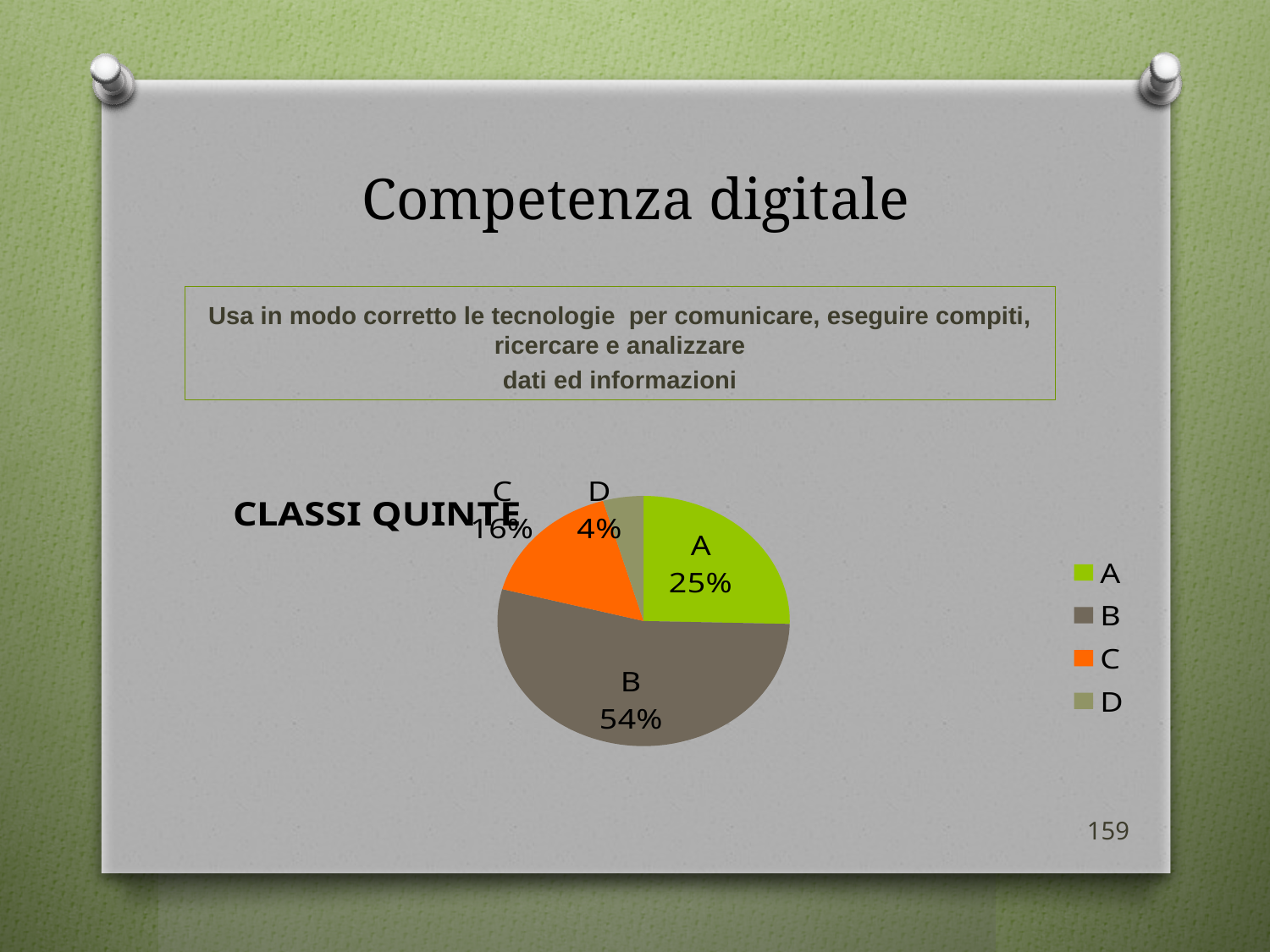
What is the title of the pie chart? CLASSI QUINTE What is the difference in percentage points between slice B and slice A? 29 What is the share for slice B in the pie chart? 54% Which slice of the pie chart is the smallest? D How many slices does the pie chart have? 4 What is the share for slice A in the pie chart? 25% Which is larger, slice A or slice C? A What kind of chart is shown on the slide? pie chart How many entries does the legend list? 4 What is the share for slice C in the pie chart? 16% Which slice of the pie chart is the largest? B What is the share for slice D in the pie chart? 4%